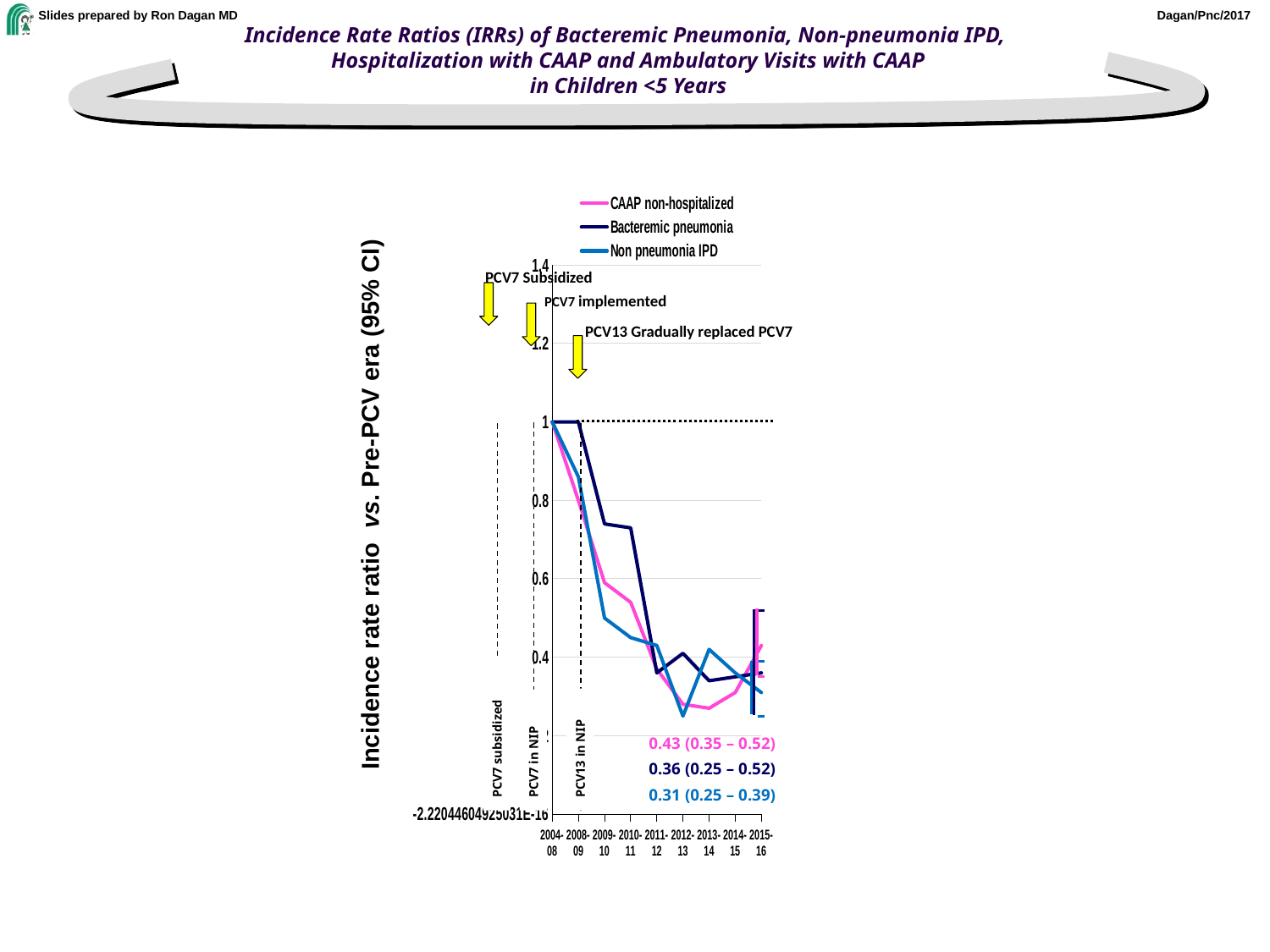
Which series has the highest incidence rate ratio in 2015-16? CAAP non-hospitalized How many time periods are shown along the x axis? 9 What is the difference between the 2015-16 incidence rate ratios for CAAP non-hospitalized and Non pneumonia IPD? 0.12 Is the incidence rate ratio for Bacteremic pneumonia in 2010-11 greater or less than 0.6? greater Do the incidence rate ratios generally rise or fall from 2004-08 to 2015-16? fall What is the incidence rate ratio for CAAP non-hospitalized in 2015-16? 0.43 What is the 95% CI printed for Non pneumonia IPD in 2015-16? 0.25 – 0.39 What is the label on the y axis? Incidence rate ratio vs. Pre-PCV era (95% CI) What is the incidence rate ratio for Bacteremic pneumonia in 2015-16? 0.36 How many series does the legend list? 3 What kind of chart is shown on the slide? line chart Which series has the lowest incidence rate ratio in 2015-16? Non pneumonia IPD